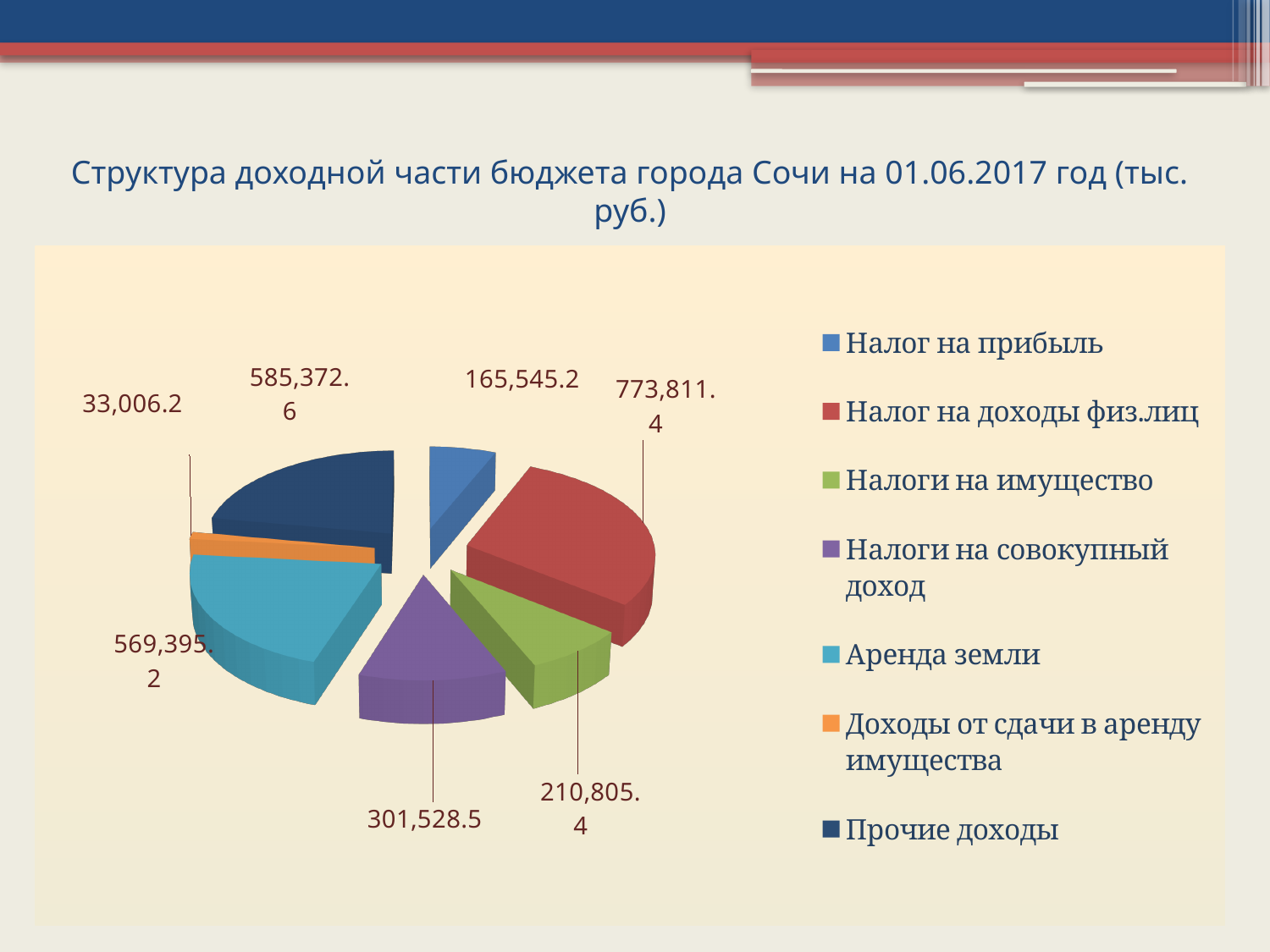
What is the difference between Налоги на совокупный доход and Налоги на имущество? 90,723.1 Which category has the highest value? Налог на доходы физ.лиц What colour is the slice for Налоги на имущество? Green Which is larger, Прочие доходы or Аренда земли? Прочие доходы What is the value for Доходы от сдачи в аренду имущества? 33,006.2 What kind of chart is shown on the slide? Pie chart Which category has the lowest value? Доходы от сдачи в аренду имущества How many categories does the pie chart show? 7 What is the difference between Налог на доходы физ.лиц and Налог на прибыль? 608,266.2 What is the value for Аренда земли? 569,395.2 What is the value for Налоги на совокупный доход? 301,528.5 What is the value for Налог на доходы физ.лиц? 773,811.4